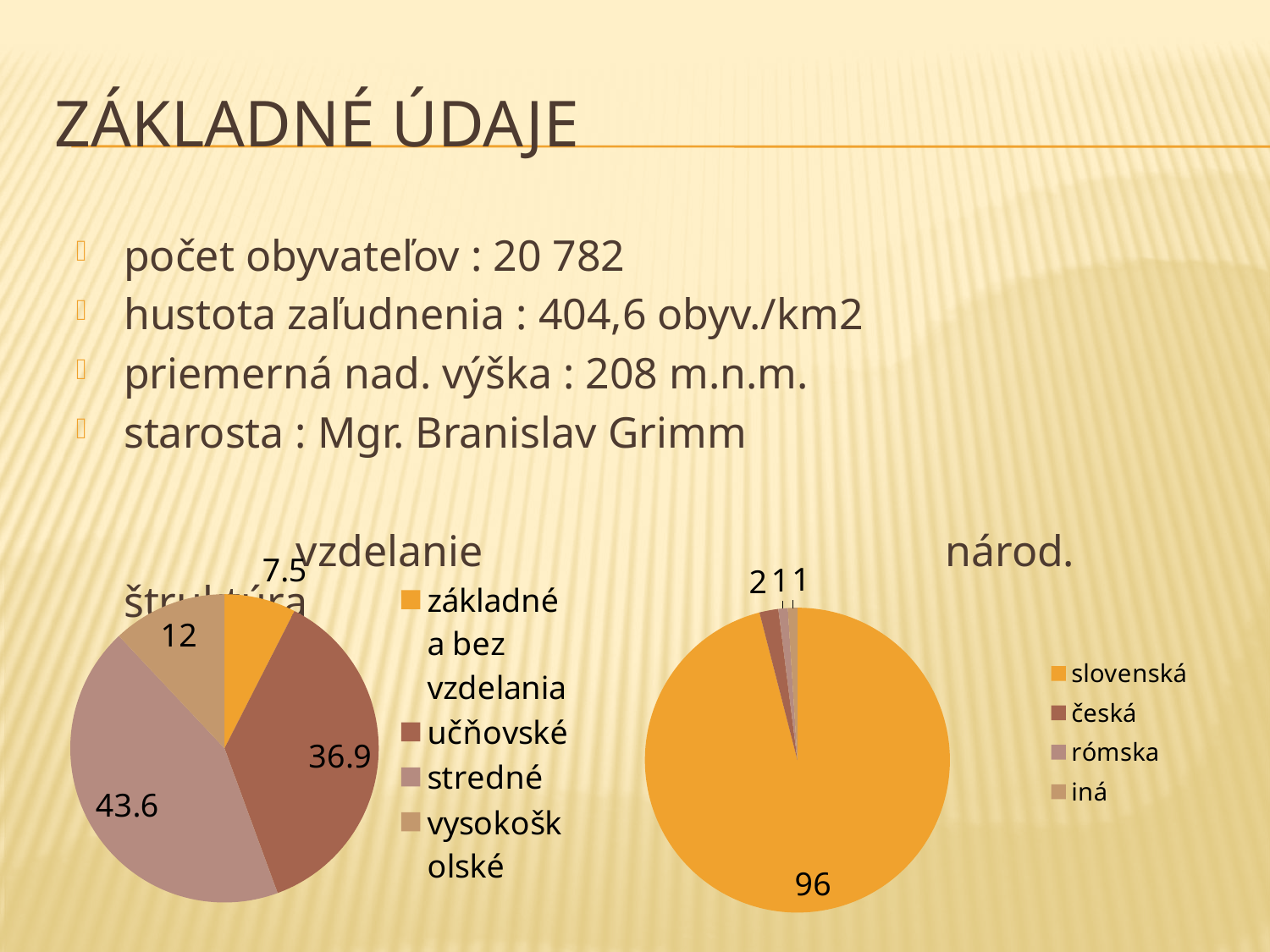
How many entries does the legend of the 'národ.' chart on the right list? 4 In the 'vzdelanie štruktúra' chart on the left, which category has the largest slice? stredné In the 'vzdelanie štruktúra' chart on the left, what is the difference between the values for 'stredné' and 'učňovské'? 6.7 In the 'vzdelanie štruktúra' chart on the left, what is the value for 'učňovské'? 36.9 In the 'národ.' chart on the right, which category has the largest slice? slovenská In the 'národ.' chart on the right, what is the value for 'česká'? 2 In the 'vzdelanie štruktúra' chart on the left, which category has the smallest slice? základné a bez vzdelania In the 'vzdelanie štruktúra' chart on the left, which is larger: 'vysokoškolské' or 'základné a bez vzdelania'? vysokoškolské In the 'národ.' chart on the right, what is the value for 'slovenská'? 96 In the 'vzdelanie štruktúra' chart on the left, what is the value for 'stredné'? 43.6 What kind of chart is the 'vzdelanie štruktúra' chart on the left? pie chart How many slices does the 'vzdelanie štruktúra' chart on the left have? 4